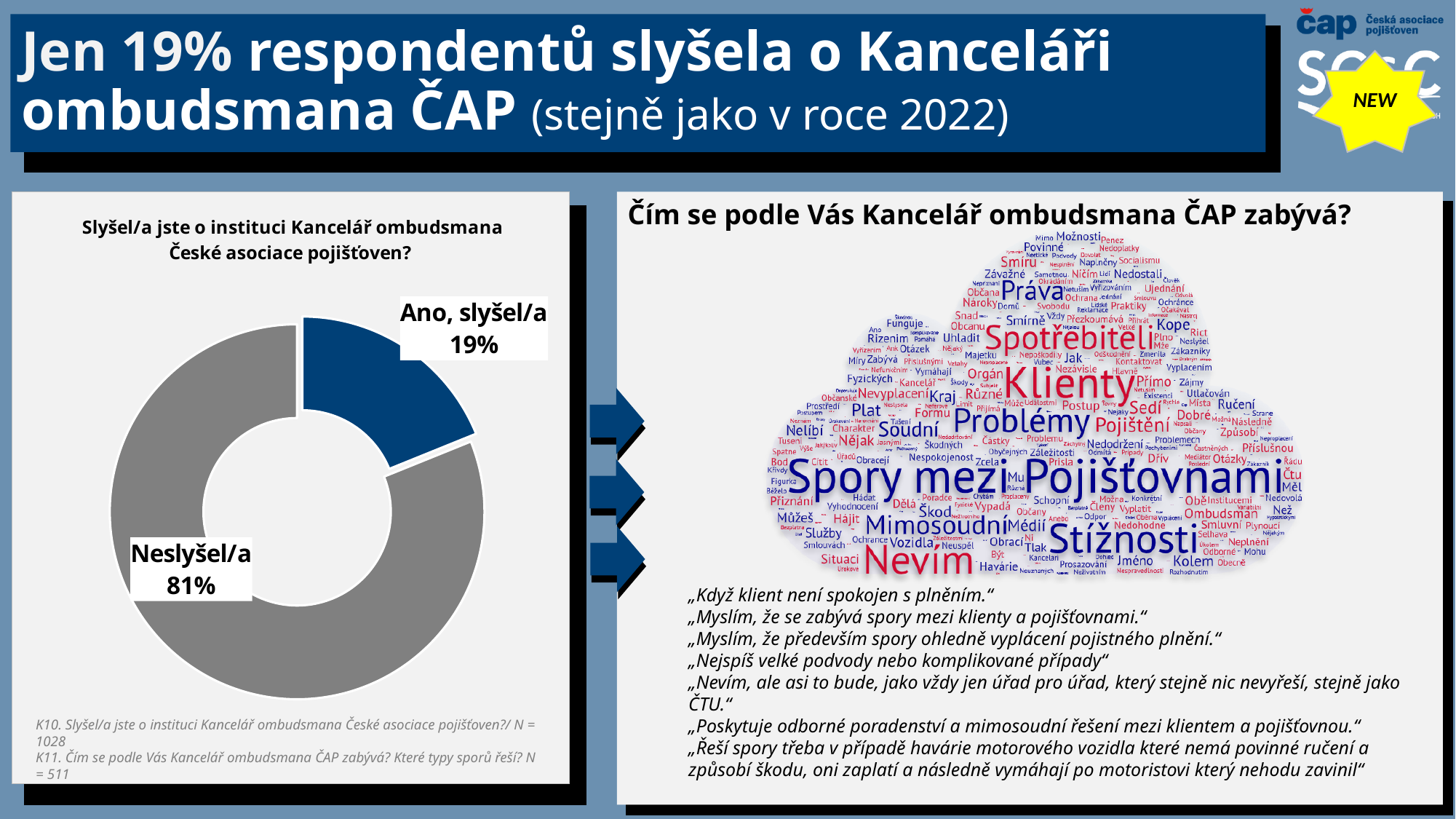
Which category has the smallest share in the donut chart? Ano, slyšel/a What is the combined share of the two slices in the donut chart? 100% What is the title of the donut chart? Slyšel/a jste o instituci Kancelář ombudsmana České asociace pojišťoven? What is the difference in percentage points between "Neslyšel/a" and "Ano, slyšel/a" in the donut chart? 62 What colour is the "Ano, slyšel/a" slice in the donut chart? Blue Which category has the largest share in the donut chart? Neslyšel/a What percentage of respondents answered "Neslyšel/a" in the donut chart? 81% How many categories are shown in the donut chart? 2 What percentage of respondents answered "Ano, slyšel/a" in the donut chart? 19% Which is larger in the donut chart: "Ano, slyšel/a" or "Neslyšel/a"? Neslyšel/a What type of chart is shown on the left side of the slide? Donut chart